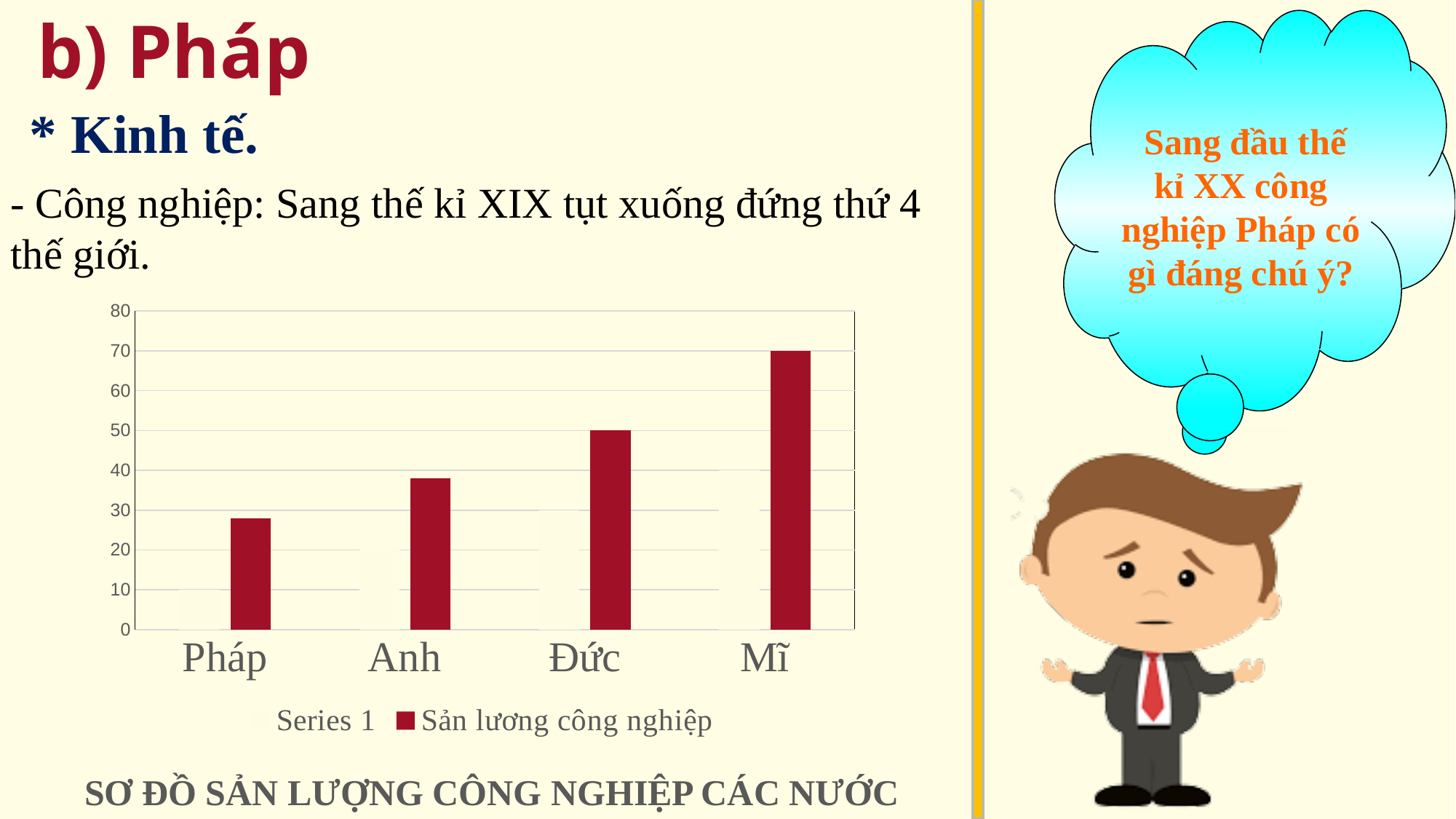
Is the value for Anh greater or less than 40? less What type of chart is shown on the slide? bar chart Do the bar values rise or fall from left to right along the x axis? rise Which has a larger value, Anh or Đức? Đức How many countries are shown on the x axis of the chart? 4 Is the value for Pháp greater or less than 30? less What is the difference between the values for Mĩ and Đức? 20 Which country has the highest bar in the chart? Mĩ What is the value for Đức in the chart? 50 What is the value for Mĩ in the chart? 70 Which country has the lowest bar in the chart? Pháp What is the title written below the chart? SƠ ĐỒ SẢN LƯỢNG CÔNG NGHIỆP CÁC NƯỚC